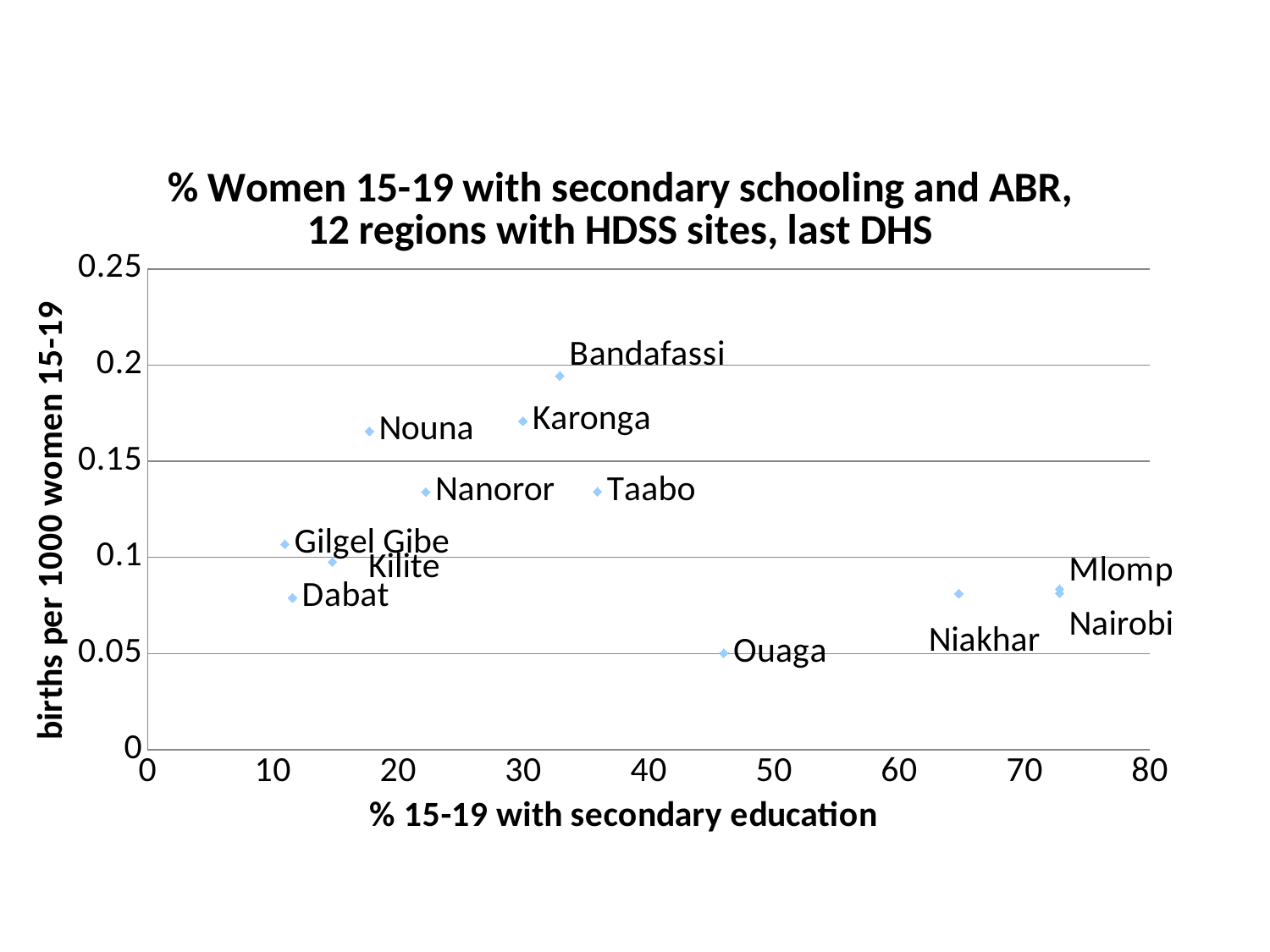
What kind of chart is shown on the slide? Scatter chart What is the label of the x axis? % 15-19 with secondary education Is the births per 1000 women 15-19 value for Taabo greater or less than 0.15? less How many regions (data points) are plotted on the chart? 12 Is the % 15-19 with secondary education for Niakhar greater or less than 60? greater Which has a higher % 15-19 with secondary education, Niakhar or Ouaga? Niakhar Which region has the highest births per 1000 women 15-19? Bandafassi Which has a higher births per 1000 women 15-19 value, Bandafassi or Nouna? Bandafassi What is the label of the y axis? births per 1000 women 15-19 Which region has the lowest births per 1000 women 15-19? Ouaga Is the % 15-19 with secondary education for Nouna greater or less than 20? less